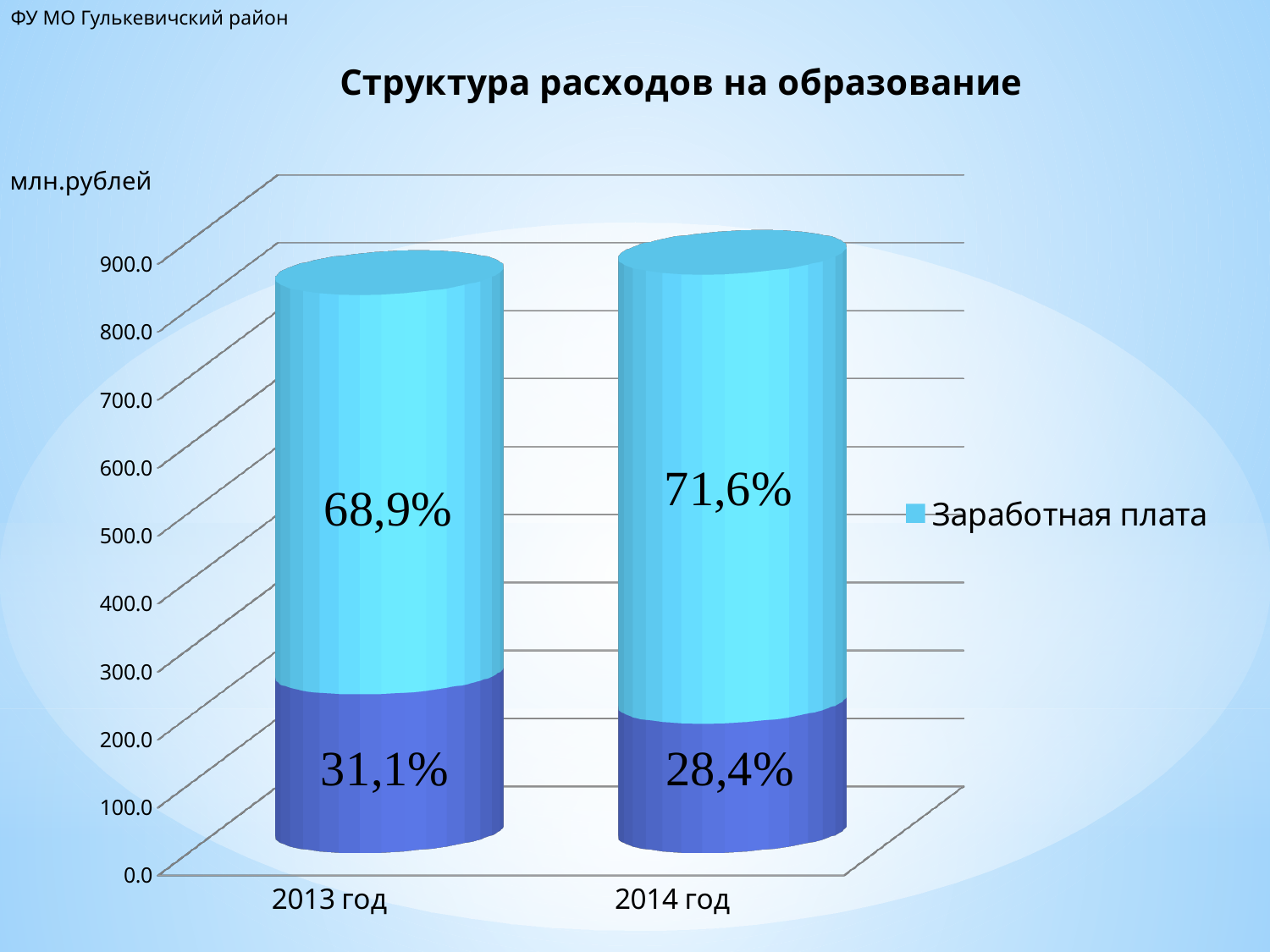
By how many percentage points does the Заработная плата share in 2014 год exceed that in 2013 год? 2,7% How many series does the legend list? 1 What is the percentage label on the light-blue (Заработная плата) segment for 2014 год? 71,6% What is the percentage label on the dark-blue lower segment for 2014 год? 28,4% Which year has the larger share for Заработная плата, 2013 год or 2014 год? 2014 год What is the percentage label on the light-blue (Заработная плата) segment for 2013 год? 68,9% Is the total height of the 2013 год bar greater or less than 500? greater What is the title of the chart? Структура расходов на образование How many categories (years) are shown on the x axis? 2 What is the percentage label on the dark-blue lower segment for 2013 год? 31,1% Does the share of Заработная плата rise or fall from 2013 год to 2014 год? rise What kind of chart is shown on the slide? bar chart (stacked)